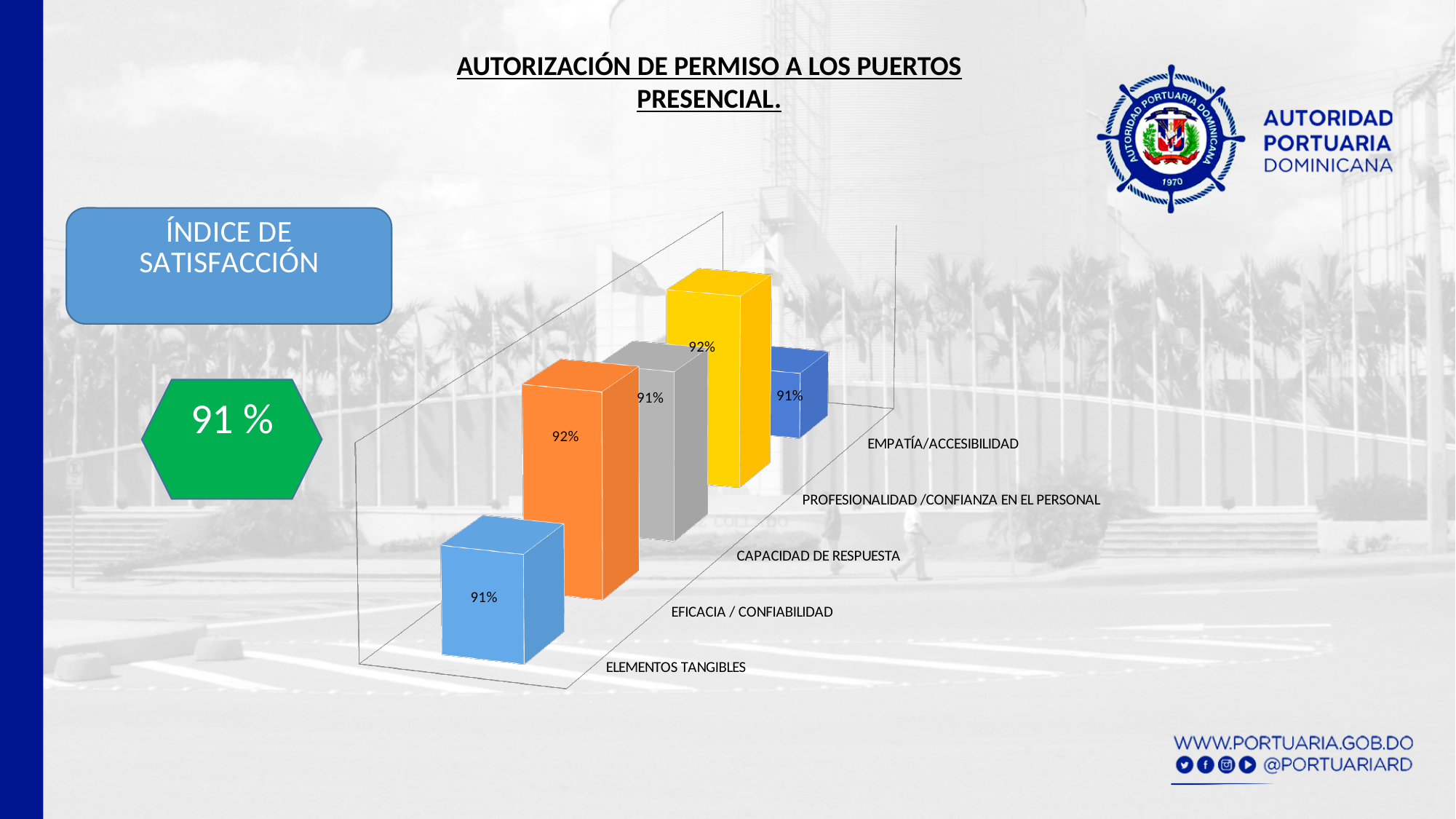
What is the value for PROFESIONALIDAD /CONFIANZA EN EL PERSONAL? 92% What is the overall ÍNDICE DE SATISFACCIÓN shown on the slide? 91 % What is the value for ELEMENTOS TANGIBLES? 91% What is the lowest value shown in the chart? 91% What is the difference between the values for EFICACIA / CONFIABILIDAD and ELEMENTOS TANGIBLES? 1% What is the highest value shown in the chart? 92% What is the value for EFICACIA / CONFIABILIDAD? 92% How many categories are shown in the chart? 5 What kind of chart is shown on the slide? Bar chart Which is larger, the value for PROFESIONALIDAD /CONFIANZA EN EL PERSONAL or the value for EMPATÍA/ACCESIBILIDAD? PROFESIONALIDAD /CONFIANZA EN EL PERSONAL What is the value for CAPACIDAD DE RESPUESTA? 91% What is the value for EMPATÍA/ACCESIBILIDAD? 91%